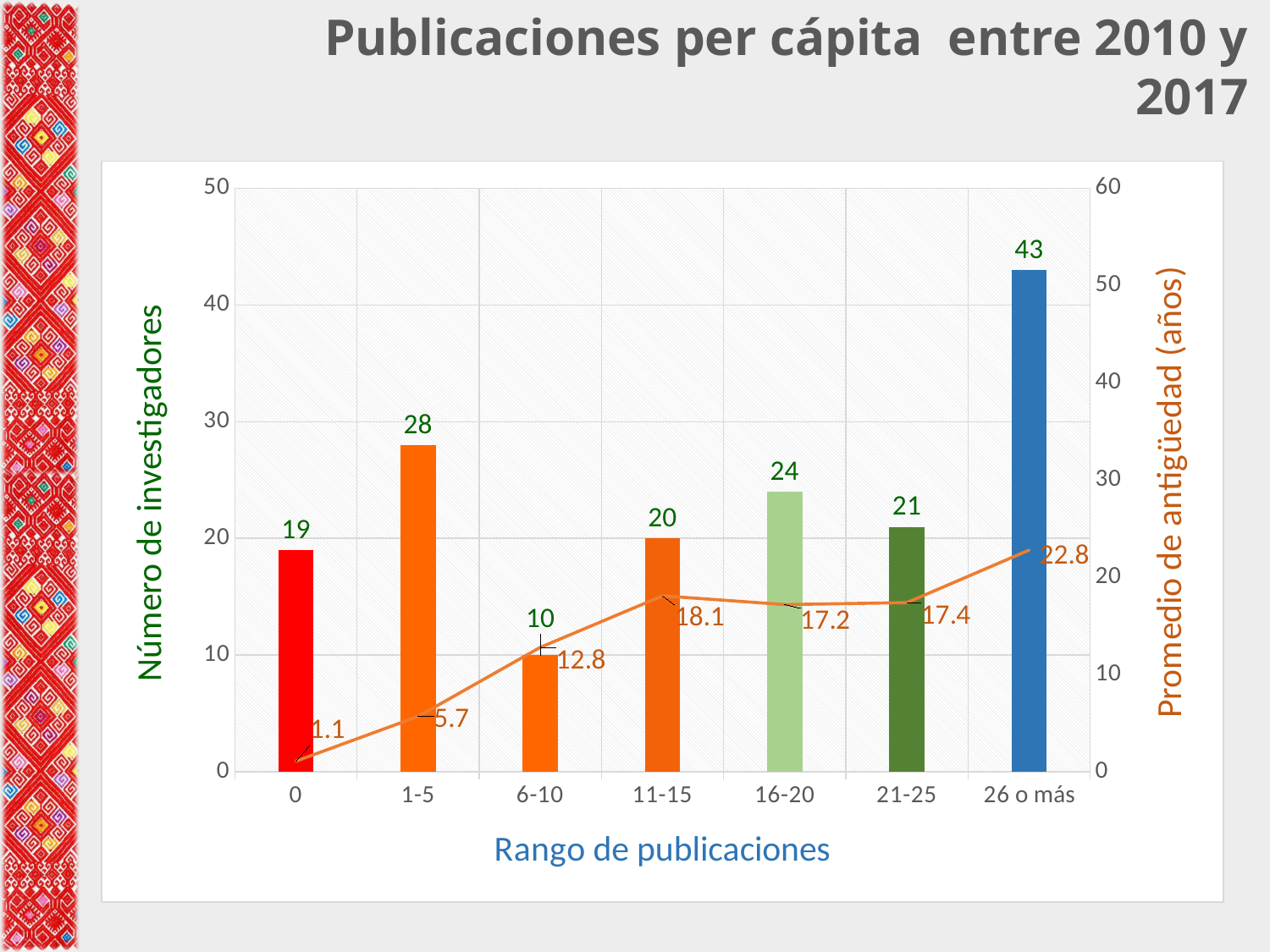
Which publication range has the highest number of researchers? 26 o más What is the average seniority value for the '0' publication range? 1.1 Does the average seniority line rise or fall from the '0' range to the '11-15' range? Rise What kind of chart is shown on the slide? Combined bar and line chart What is the label of the left vertical axis? Número de investigadores What is the difference in number of researchers between the '1-5' and '6-10' ranges? 18 How many researchers (Número de investigadores) are in the '26 o más' publication range? 43 Which publication range has the lowest number of researchers? 6-10 What is the label of the x axis? Rango de publicaciones What is the average seniority (Promedio de antigüedad) for the '11-15' publication range? 18.1 How many publication ranges are shown on the x axis? 7 Which has more researchers, the '16-20' range or the '21-25' range? 16-20